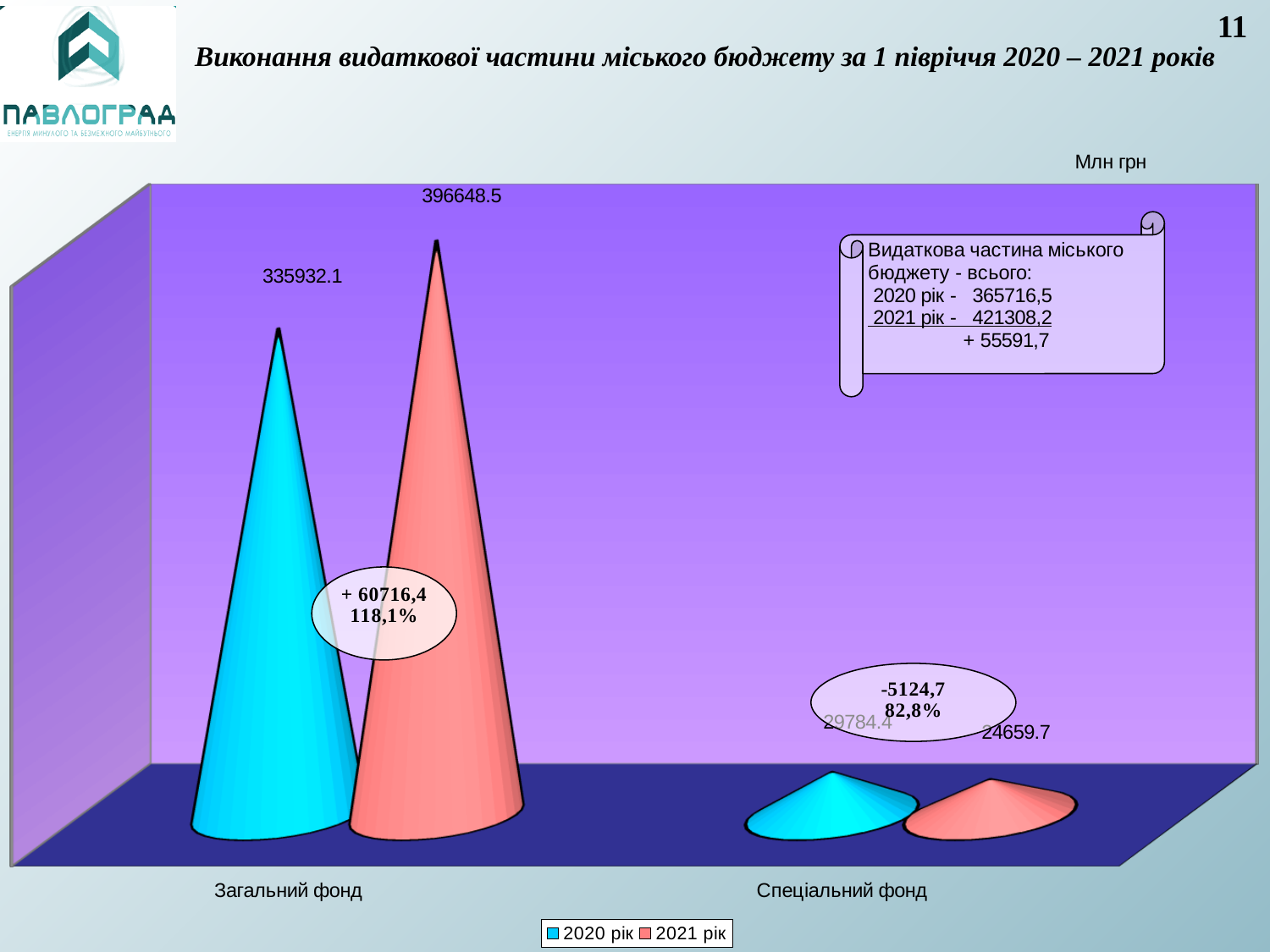
What is the value for Загальний фонд in the 2021 рік series? 396648.5 Which category has the lowest value in the 2020 рік series? Спеціальний фонд How many series does the legend list? 2 For Спеціальний фонд, which series has the larger value, 2020 рік or 2021 рік? 2020 рік What is the difference between the 2021 рік and 2020 рік values for Загальний фонд? 60716.4 What unit is indicated above the chart? Млн грн What is the value for Спеціальний фонд in the 2021 рік series? 24659.7 What is the value for Спеціальний фонд in the 2020 рік series? 29784.4 What is the difference between the 2020 рік and 2021 рік values for Спеціальний фонд? 5124.7 Which category has the highest value in the 2021 рік series? Загальний фонд What is the value for Загальний фонд in the 2020 рік series? 335932.1 How many categories are shown on the x axis of the chart? 2